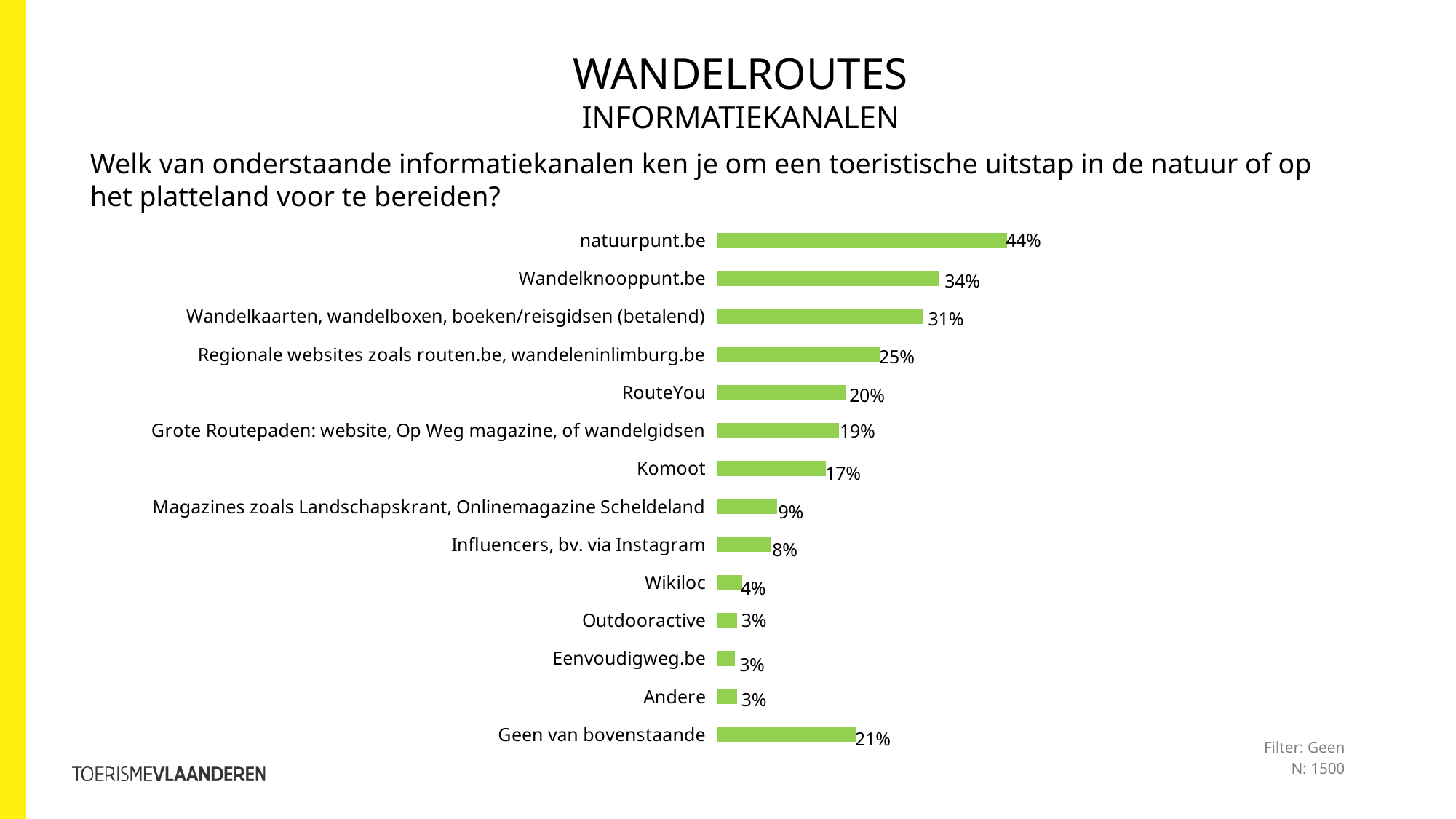
What is the difference between the values for natuurpunt.be and Wandelknooppunt.be? 10% Which is larger, the value for Geen van bovenstaande or the value for Komoot? Geen van bovenstaande How many categories are shown in the chart? 14 Which category has the highest value? natuurpunt.be What kind of chart is shown on the slide? bar chart What is the value for Geen van bovenstaande? 21% What is the value for natuurpunt.be? 44% What is the value for Komoot? 17% What is the value for Influencers, bv. via Instagram? 8% What is the difference between the values for RouteYou and Wikiloc? 16% What colour are the bars in the chart? green Which is larger, the value for Regionale websites zoals routen.be, wandeleninlimburg.be or the value for RouteYou? Regionale websites zoals routen.be, wandeleninlimburg.be